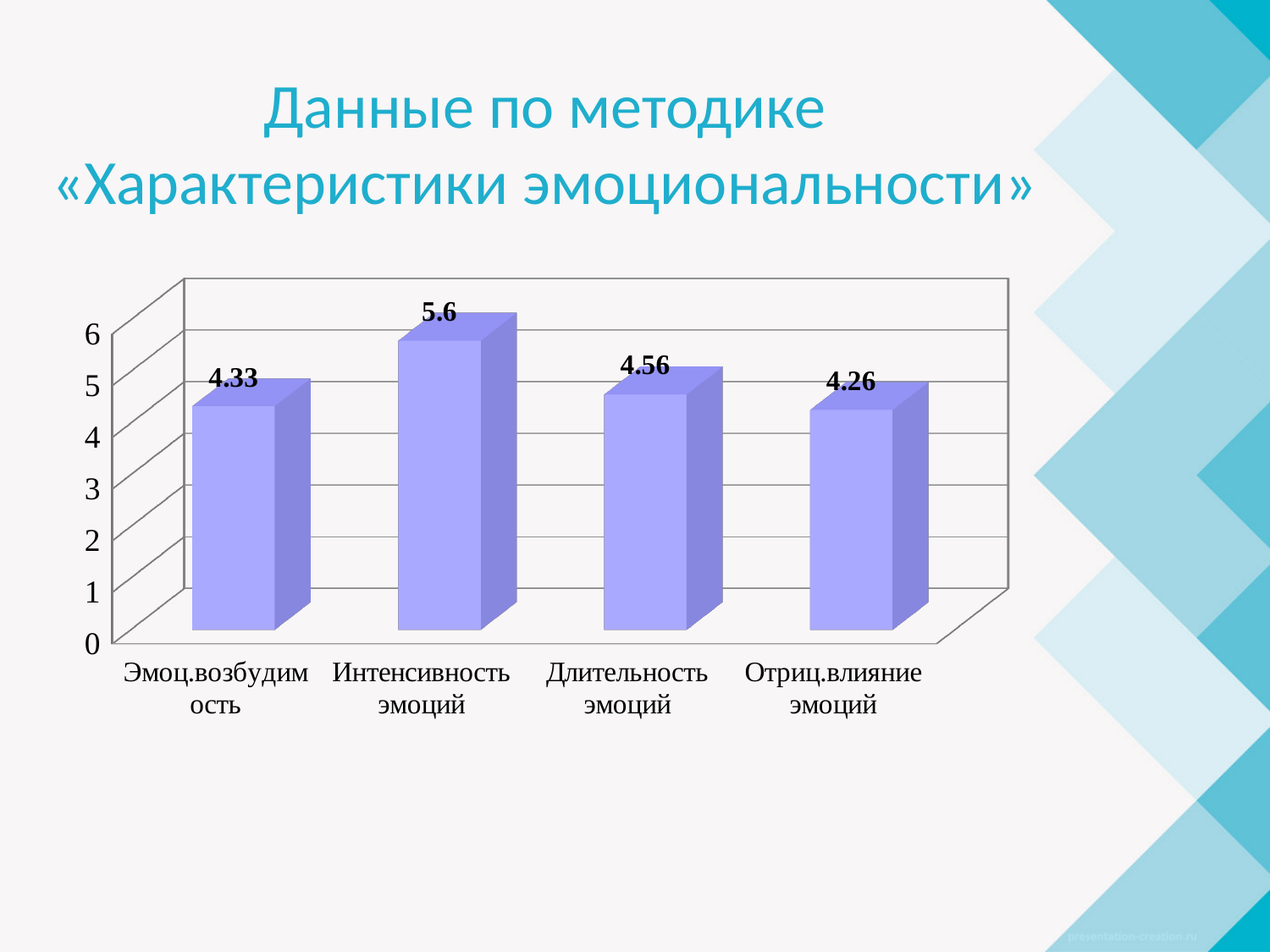
Which is larger, the value for Интенсивность эмоций or the value for Длительность эмоций? Интенсивность эмоций Which category has the highest value? Интенсивность эмоций What is the value for Эмоц.возбудимость? 4.33 What is the value for Интенсивность эмоций? 5.6 Which category has the lowest value? Отриц.влияние эмоций How many categories are shown in the chart? 4 What is the value for Отриц.влияние эмоций? 4.26 What is the value for Длительность эмоций? 4.56 What kind of chart is shown on the slide? Bar chart What is the title of the slide? Данные по методике «Характеристики эмоциональности» What is the difference between the values for Длительность эмоций and Отриц.влияние эмоций? 0.3 What is the difference between the values for Интенсивность эмоций and Эмоц.возбудимость? 1.27